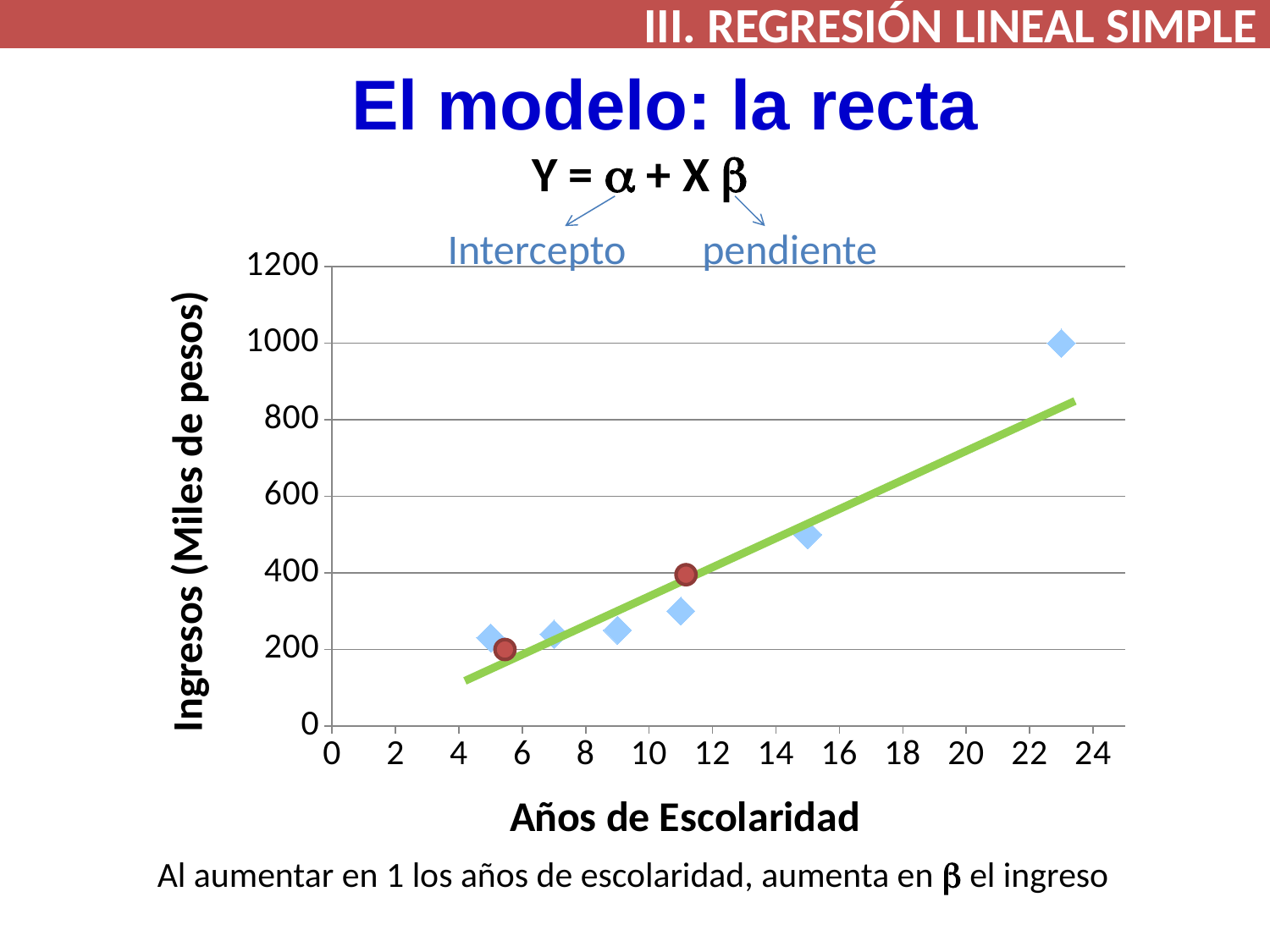
What is the title of the y axis of the chart? Ingresos (Miles de pesos) What is the maximum value shown on the y axis of the chart? 1200 At how many years of schooling is the highest plotted income value found? 23 How many blue diamond data points are plotted on the chart? 6 Which plotted point has the highest income value: the one at 15 years or the one at 23 years of schooling? 23 years What is the title of the x axis of the chart? Años de Escolaridad Is the income value for the point at 5 years of schooling greater or less than 400? less Is the income value for the point at 11 years of schooling greater or less than 400? less What kind of chart is shown on the slide? scatter plot Is the income value for the point at 23 years of schooling greater or less than 800? greater Do the plotted income values rise or fall as years of schooling increase along the x axis? rise